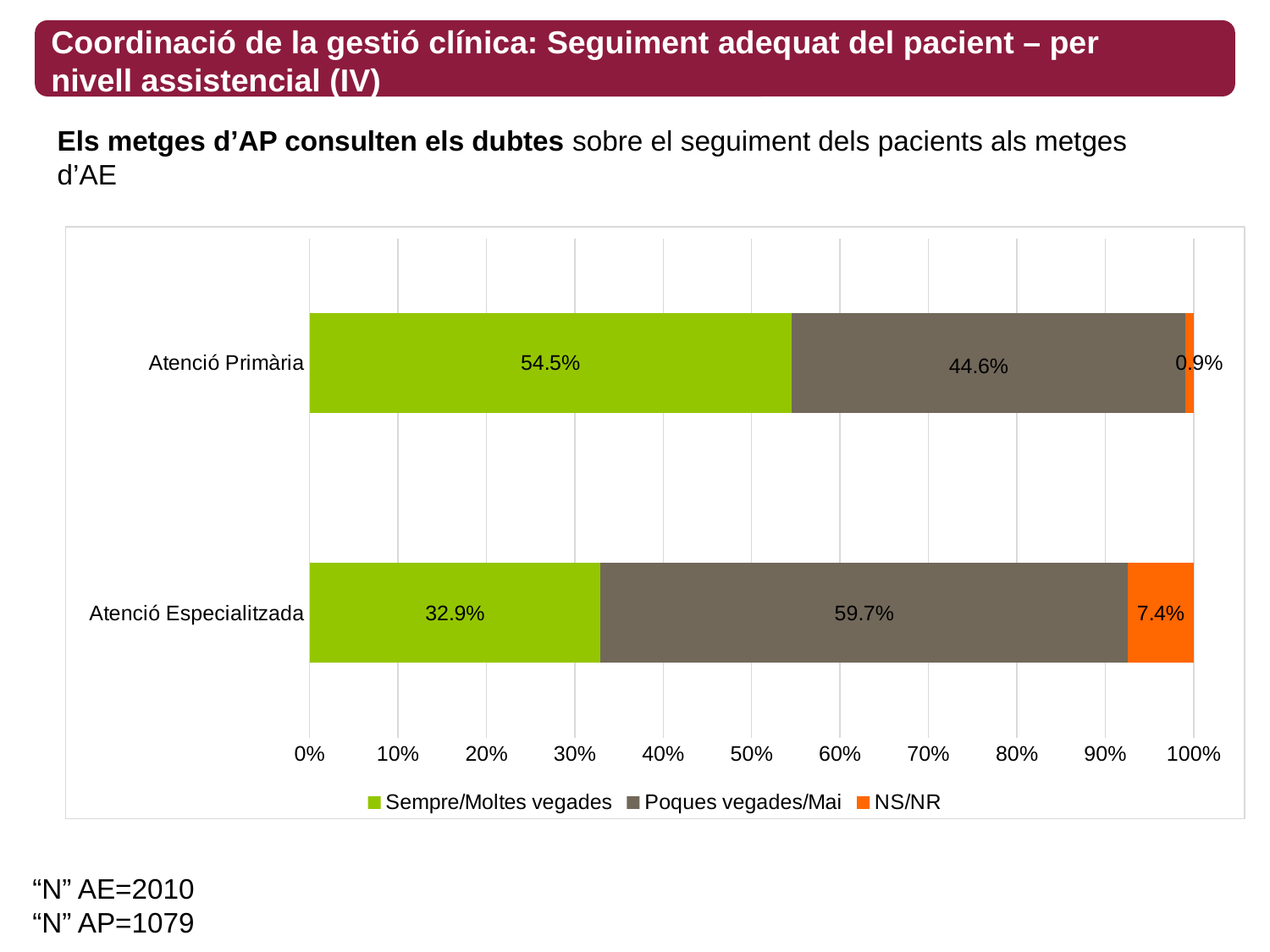
What is the difference between the Sempre/Moltes vegades values for Atenció Primària and Atenció Especialitzada? 21.6% Is the NS/NR value larger for Atenció Primària or Atenció Especialitzada? Atenció Especialitzada What kind of chart is shown on the slide? Stacked bar chart What is the value of Poques vegades/Mai for Atenció Especialitzada? 59.7% What colour represents the NS/NR series? Orange How many series does the legend list? 3 Which category has the lower value for Poques vegades/Mai? Atenció Primària What is the value of Sempre/Moltes vegades for Atenció Primària? 54.5% Which category has the higher value for Sempre/Moltes vegades? Atenció Primària What is the value of NS/NR for Atenció Primària? 0.9% What is the value of NS/NR for Atenció Especialitzada? 7.4% How many categories are shown on the chart? 2